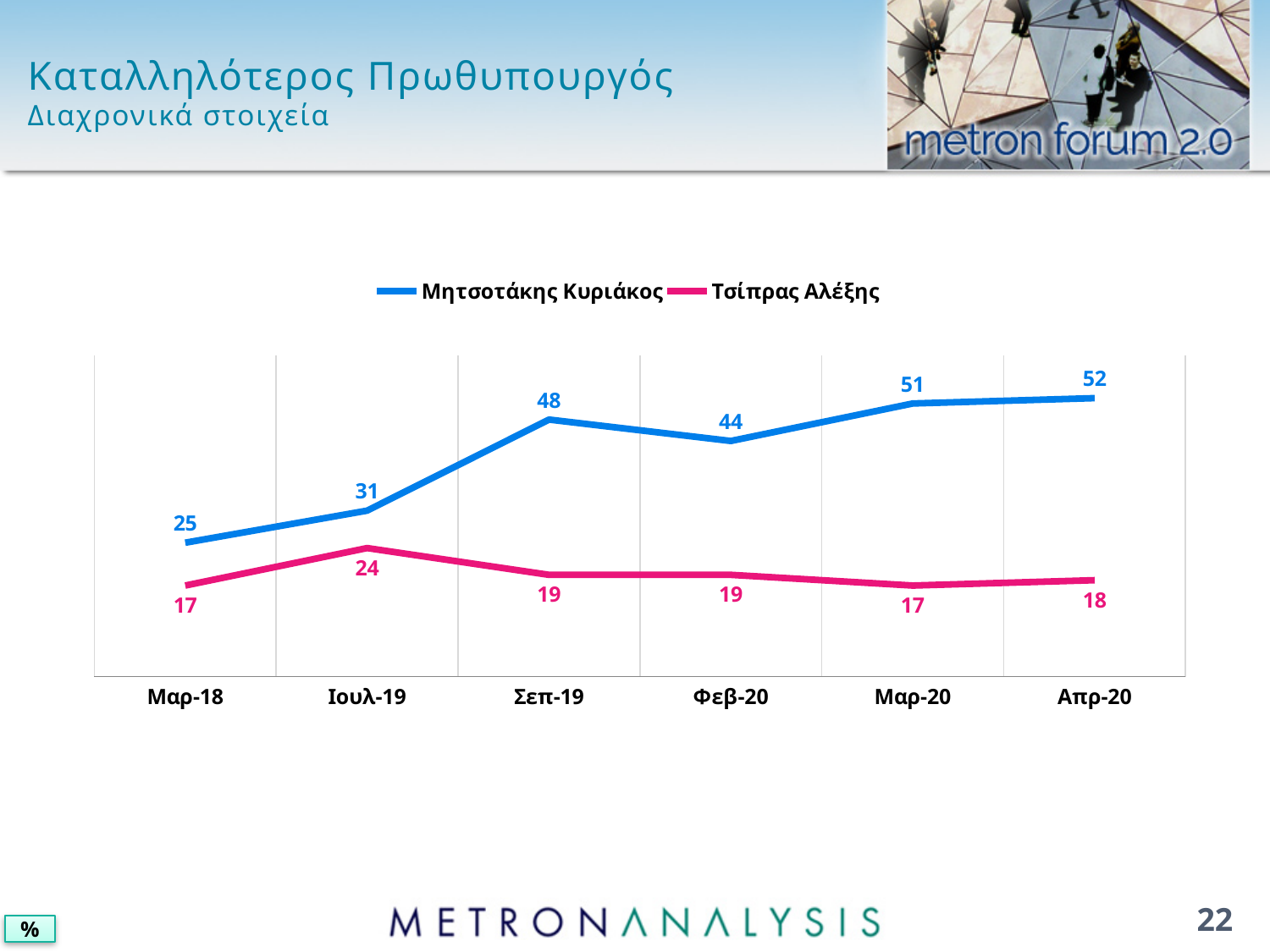
Which series has the higher value in Φεβ-20, Μητσοτάκης Κυριάκος or Τσίπρας Αλέξης? Μητσοτάκης Κυριάκος How many series does the legend list? 2 What is the difference between Μητσοτάκης Κυριάκος and Τσίπρας Αλέξης in Απρ-20? 34 In which period does Μητσοτάκης Κυριάκος have his lowest value? Μαρ-18 What is the value for Τσίπρας Αλέξης in Ιουλ-19? 24 In which period does Μητσοτάκης Κυριάκος reach his highest value? Απρ-20 How many time periods are shown on the x axis? 6 What is the value for Μητσοτάκης Κυριάκος in Σεπ-19? 48 What kind of chart is shown on the slide? Line chart What is the value for Μητσοτάκης Κυριάκος in Μαρ-18? 25 Does the value for Μητσοτάκης Κυριάκος rise or fall from Μαρ-18 to Σεπ-19? Rise In which period does Τσίπρας Αλέξης reach his highest value? Ιουλ-19